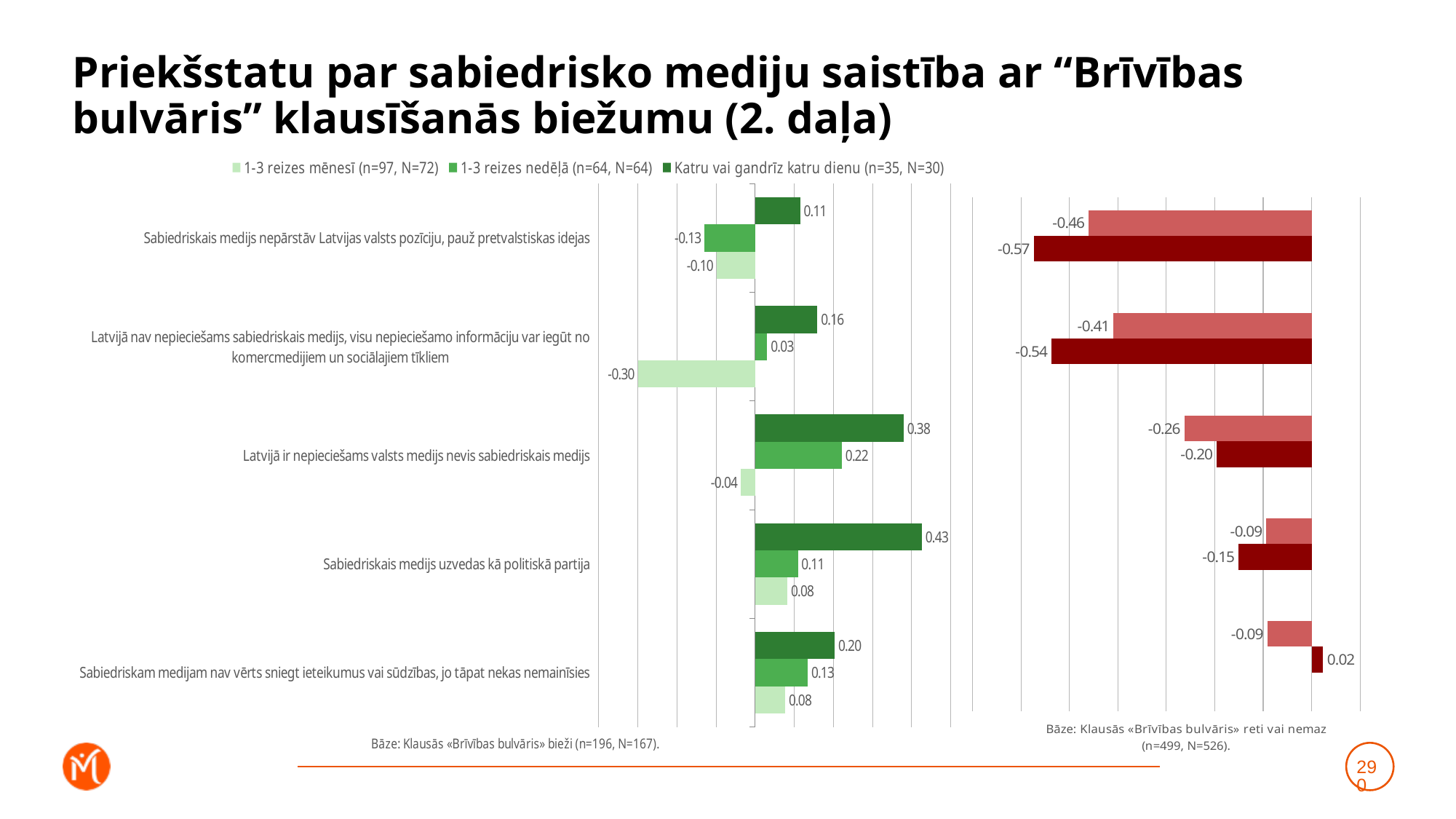
How many statements (categories) are shown in the left (green) chart? 5 What base (Bāze) is stated below the left (green) chart? Klausās «Brīvības bulvāris» bieži (n=196, N=167) In the left (green) chart, what is the value for '1-3 reizes mēnesī' for the statement 'Latvijā nav nepieciešams sabiedriskais medijs, visu nepieciešamo informāciju var iegūt no komercmedijiem un sociālajiem tīkliem'? -0.30 In the left (green) chart, for the statement 'Sabiedriskam medijam nav vērts sniegt ieteikumus vai sūdzības, jo tāpat nekas nemainīsies', which is larger: the '1-3 reizes nedēļā' value or the '1-3 reizes mēnesī' value? 1-3 reizes nedēļā In the right (red) chart, what is the only positive value shown? 0.02 In the right (red) chart, what is the lowest value shown? -0.57 In the left (green) chart, which statement has the highest value for the 'Katru vai gandrīz katru dienu' series? Sabiedriskais medijs uzvedas kā politiskā partija How many series does the legend at the top of the slide list? 3 In the left (green) chart, what is the lowest value shown? -0.30 In the left (green) chart, for the statement 'Latvijā ir nepieciešams valsts medijs nevis sabiedriskais medijs', what is the difference between the 'Katru vai gandrīz katru dienu' value and the '1-3 reizes nedēļā' value? 0.16 In the left (green) chart, what is the value for 'Katru vai gandrīz katru dienu' for the statement 'Sabiedriskais medijs uzvedas kā politiskā partija'? 0.43 What type of chart is used on this slide? Bar chart